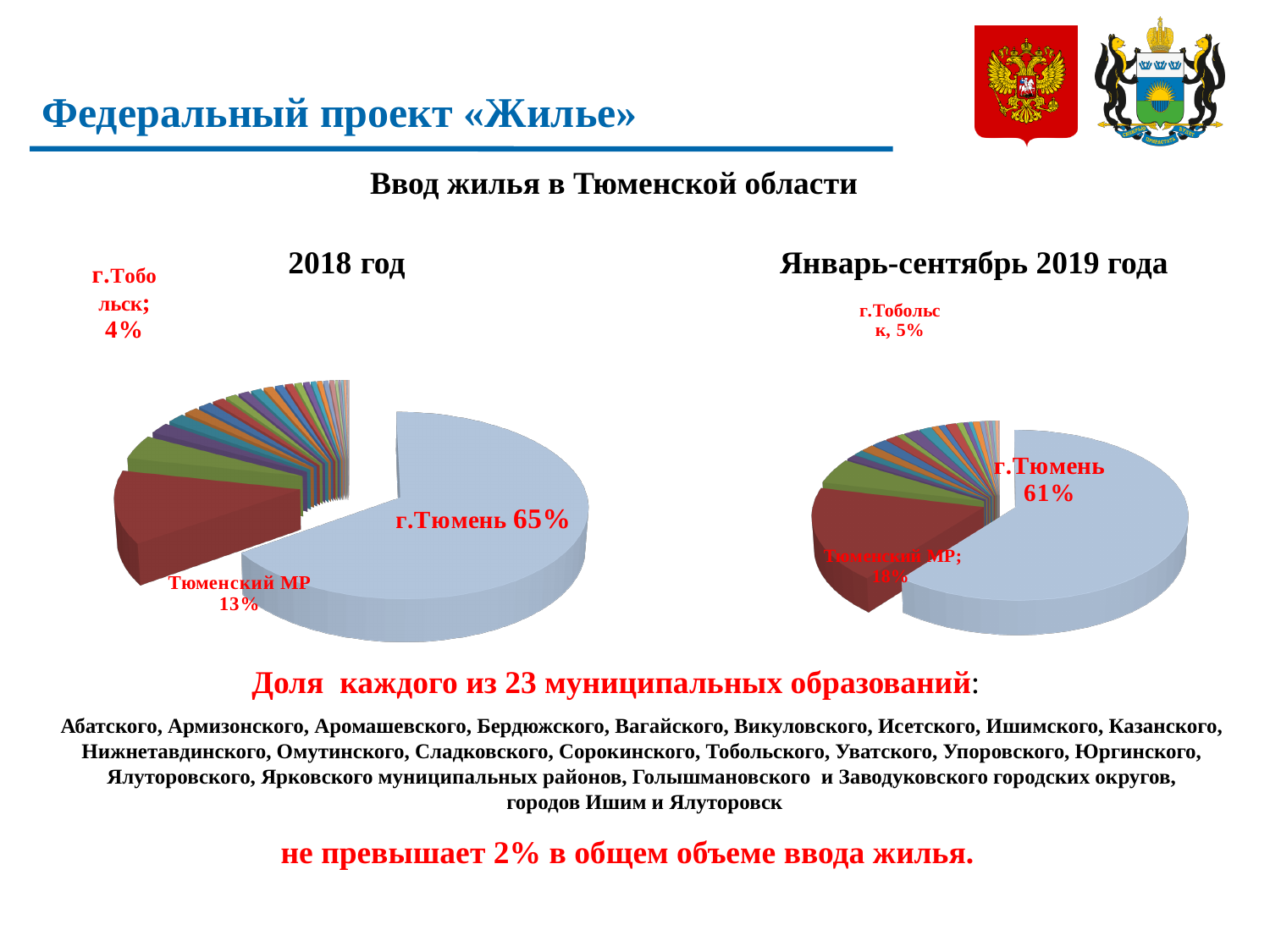
In the 2018 год pie chart, what share does г.Тюмень have? 65% What type of chart is used for the 2018 год data? Pie chart In the Январь-сентябрь 2019 года pie chart, what share does г.Тобольск have? 5% What is the common title above the two charts? Ввод жилья в Тюменской области Is the share of Тюменский МР larger in the 2018 год chart or in the Январь-сентябрь 2019 года chart? Январь-сентябрь 2019 года In the Январь-сентябрь 2019 года pie chart, what share does г.Тюмень have? 61% In the 2018 год pie chart, which labelled category has the largest share? г.Тюмень In the Январь-сентябрь 2019 года pie chart, what share does Тюменский МР have? 18% By how many percentage points did the share of г.Тюмень change from the 2018 год chart to the Январь-сентябрь 2019 года chart? 4 percentage points lower (65% to 61%) In the 2018 год pie chart, what share does г.Тобольск have? 4% In the 2018 год pie chart, what share does Тюменский МР have? 13% In the Январь-сентябрь 2019 года pie chart, which labelled category has the largest share? г.Тюмень